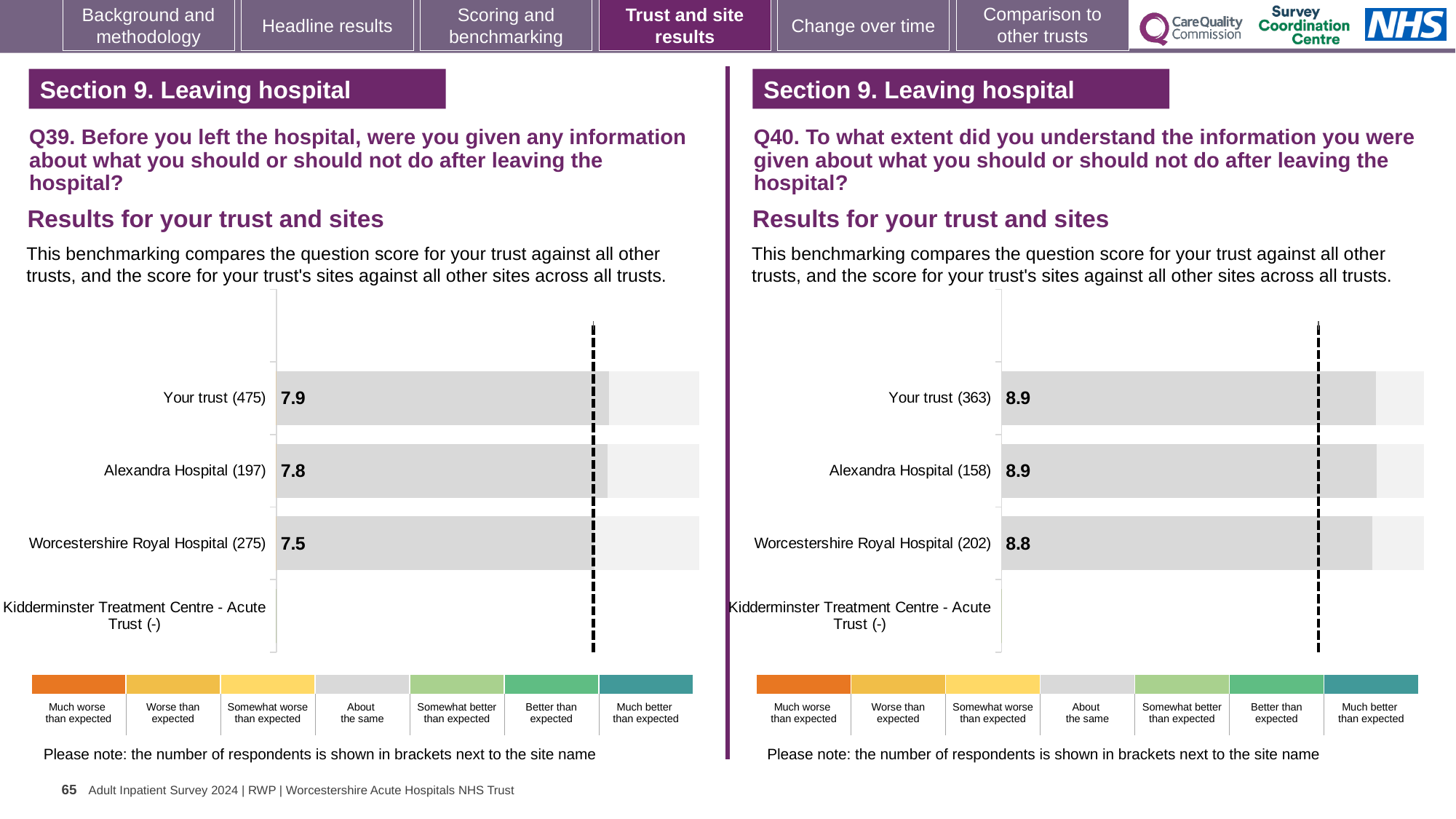
What type of chart is used on the Q39 chart (left)? Bar chart On the Q39 chart (left), what is the score for Your trust? 7.9 On the Q39 chart (left), which site or trust row has the lowest score shown? Worcestershire Royal Hospital On the Q40 chart (right), what is the score for Alexandra Hospital? 8.9 On the Q39 chart (left), which has the higher score, Alexandra Hospital or Worcestershire Royal Hospital? Alexandra Hospital On the Q40 chart (right), what is the score for Worcestershire Royal Hospital? 8.8 On the Q39 chart (left), what is the score for Worcestershire Royal Hospital? 7.5 On the Q40 chart (right), how many respondents are shown in brackets for Your trust? 363 On the Q40 chart (right), what is the difference between the scores for Alexandra Hospital and Worcestershire Royal Hospital? 0.1 On the Q39 chart (left), how many respondents are shown in brackets for Alexandra Hospital? 197 How many rows (trust and sites) are listed on the Q40 chart (right)? 4 On the Q39 chart (left), what is the difference between the scores for Your trust and Worcestershire Royal Hospital? 0.4